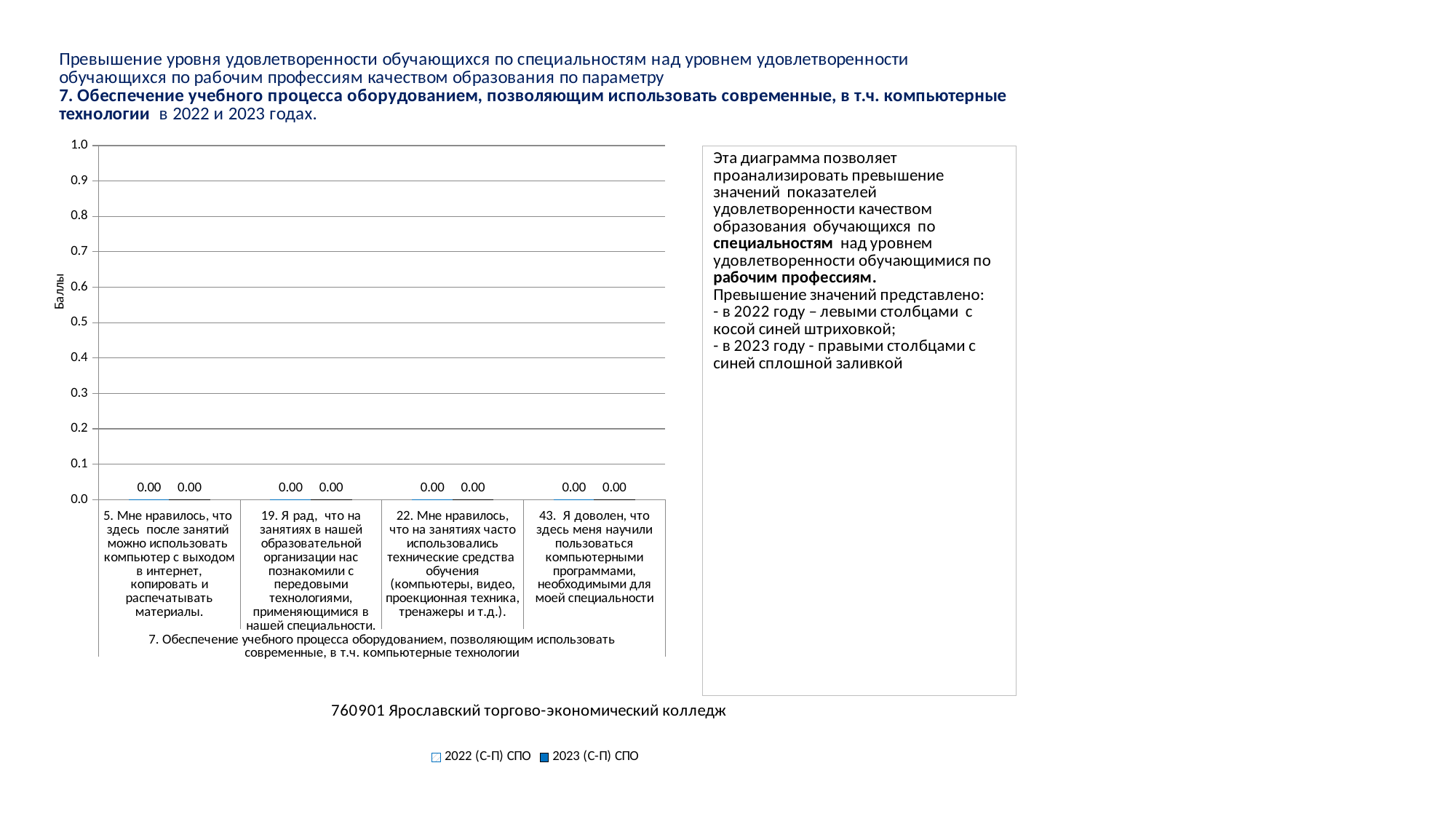
What is the label of the vertical axis of the chart? Баллы How many series does the chart legend list? 2 Is the value for 2023 (С-П) СПО for statement 5 greater or less than 0.5? less What is the value for 2023 (С-П) СПО for statement 43 ("Я доволен, что здесь меня научили пользоваться компьютерными программами...")? 0.00 Do the 2022 (С-П) СПО values rise, fall, or stay the same across the categories on the x axis? stay the same What are the two series names listed in the chart legend? 2022 (С-П) СПО and 2023 (С-П) СПО What is the value for 2022 (С-П) СПО for statement 22 ("Мне нравилось, что на занятиях часто использовались технические средства обучения...")? 0.00 What is the value for 2022 (С-П) СПО for statement 5 ("Мне нравилось, что здесь после занятий можно использовать компьютер с выходом в интернет...")? 0.00 What is the difference between the 2022 (С-П) СПО and 2023 (С-П) СПО values for statement 43? 0.00 How many categories (survey statements) are shown on the x axis of the chart? 4 What is the value for 2023 (С-П) СПО for statement 19 ("Я рад, что на занятиях в нашей образовательной организации нас познакомили с передовыми технологиями...")? 0.00 What kind of chart is shown on the slide? bar chart